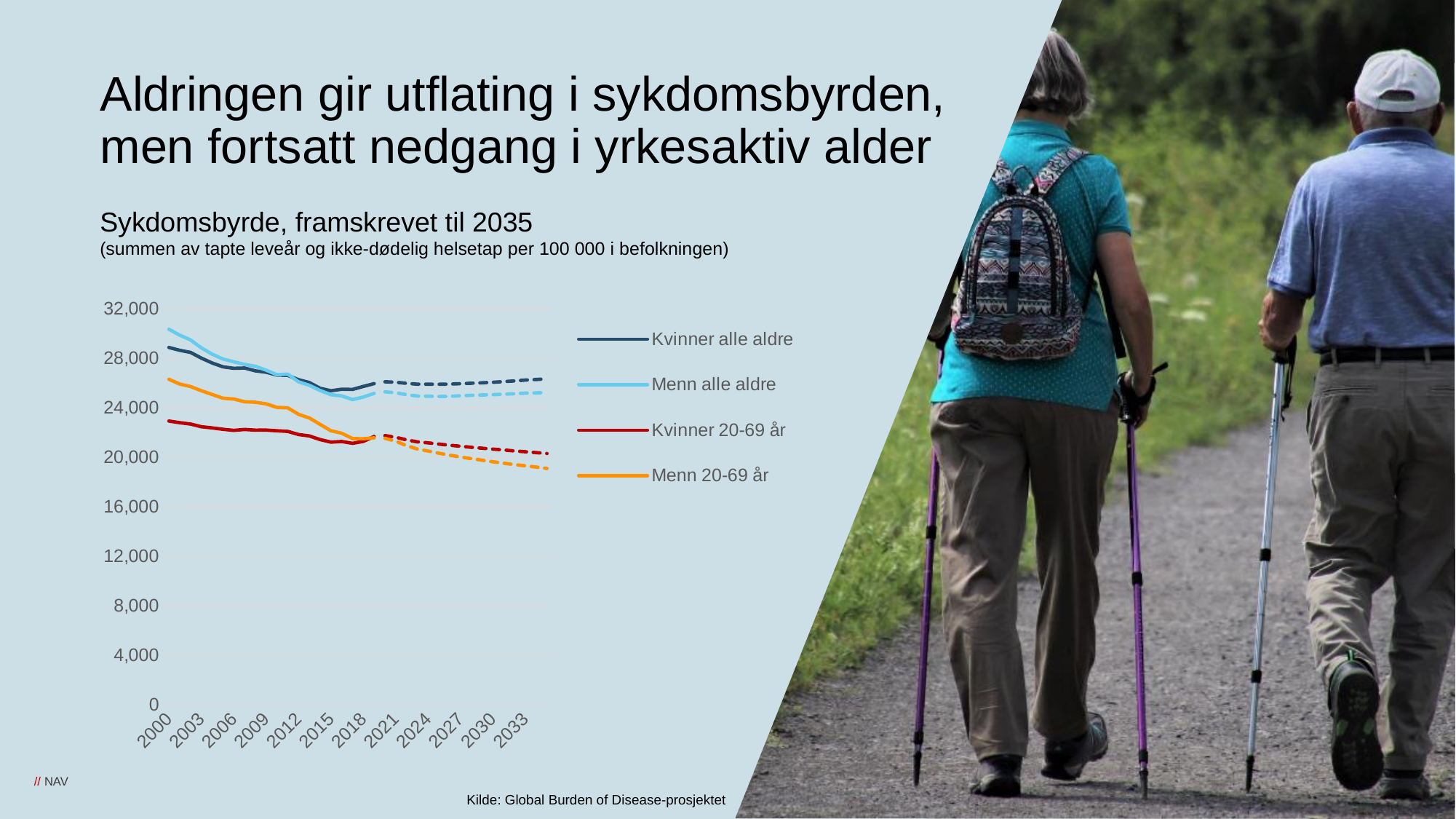
What kind of chart is shown on the slide? Line chart What is the title of the chart? Sykdomsbyrde, framskrevet til 2035 Which series has the lowest value in 2000? Kvinner 20-69 år Is the value for Menn alle aldre in 2000 greater or less than 28,000? greater Which series has the highest value in 2000? Menn alle aldre Which series has the lowest value at the end of the projection (2035)? Menn 20-69 år In 2035, which is higher: Kvinner alle aldre or Menn alle aldre? Kvinner alle aldre Does the Menn 20-69 år series rise or fall from 2000 to 2035? Fall Which series is shown with an orange line? Menn 20-69 år How many series does the chart legend list? 4 Is the value for Kvinner 20-69 år in 2000 greater or less than 24,000? less Is the value for Menn 20-69 år in 2035 greater or less than 20,000? less